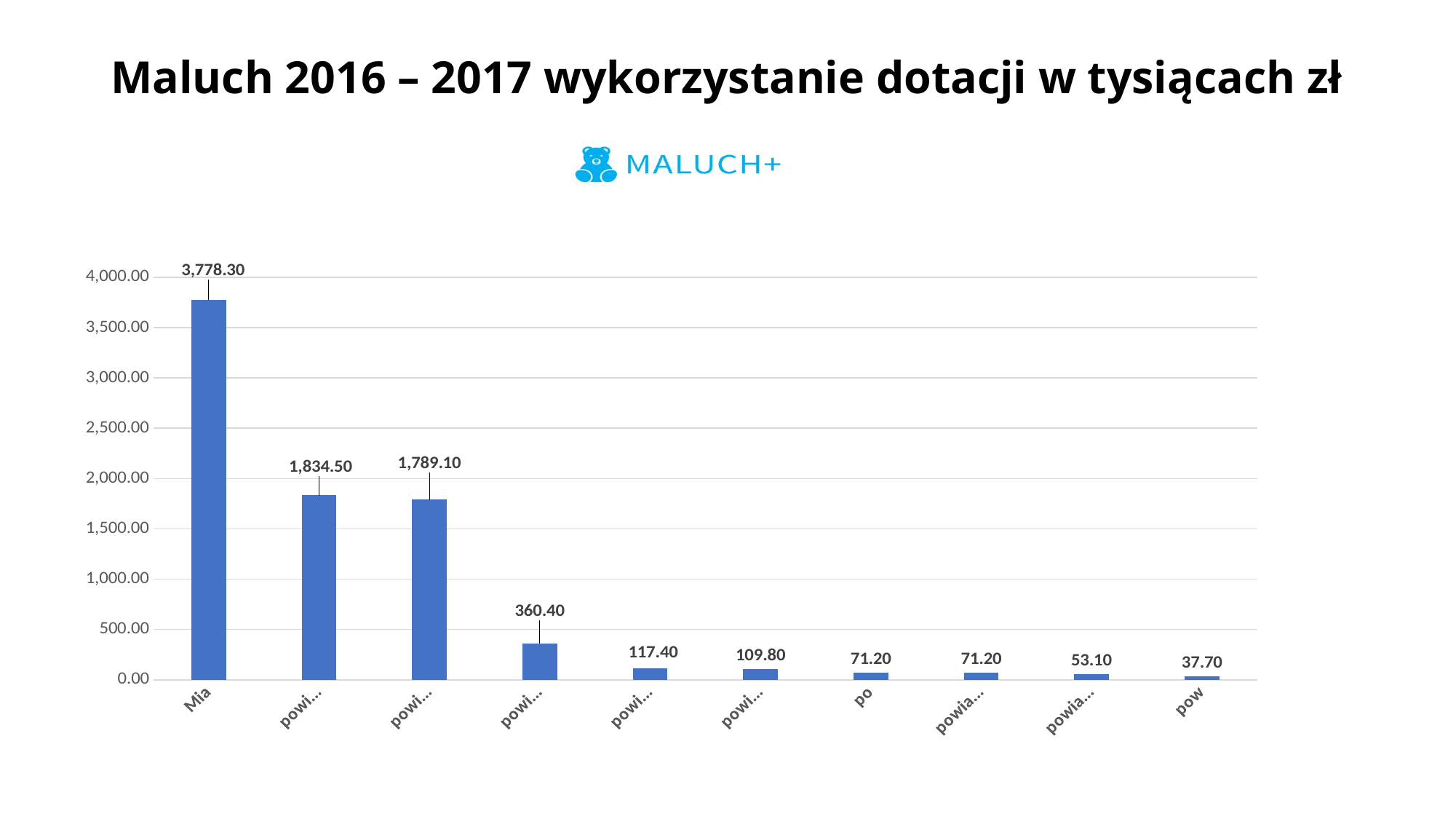
What is the value of the rightmost bar (labelled "pow")? 37.70 What is the title of the chart on the slide? Maluch 2016 – 2017 wykorzystanie dotacji w tysiącach zł Do the bar values rise or fall from left to right along the x axis? fall What is the value of the fourth bar from the left? 360.40 What is the value of the tallest bar in the chart? 3,778.30 What is the value of the leftmost bar (labelled "Mia")? 3,778.30 What kind of chart is shown on the slide? bar chart What is the difference between the first bar (3,778.30) and the second bar (1,834.50)? 1,943.80 How many bars are plotted in the chart? 10 What is the difference between the second bar (1,834.50) and the third bar (1,789.10)? 45.40 What is the value of the shortest bar in the chart? 37.70 Which is larger, the second bar from the left or the third bar from the left? the second bar (1,834.50)